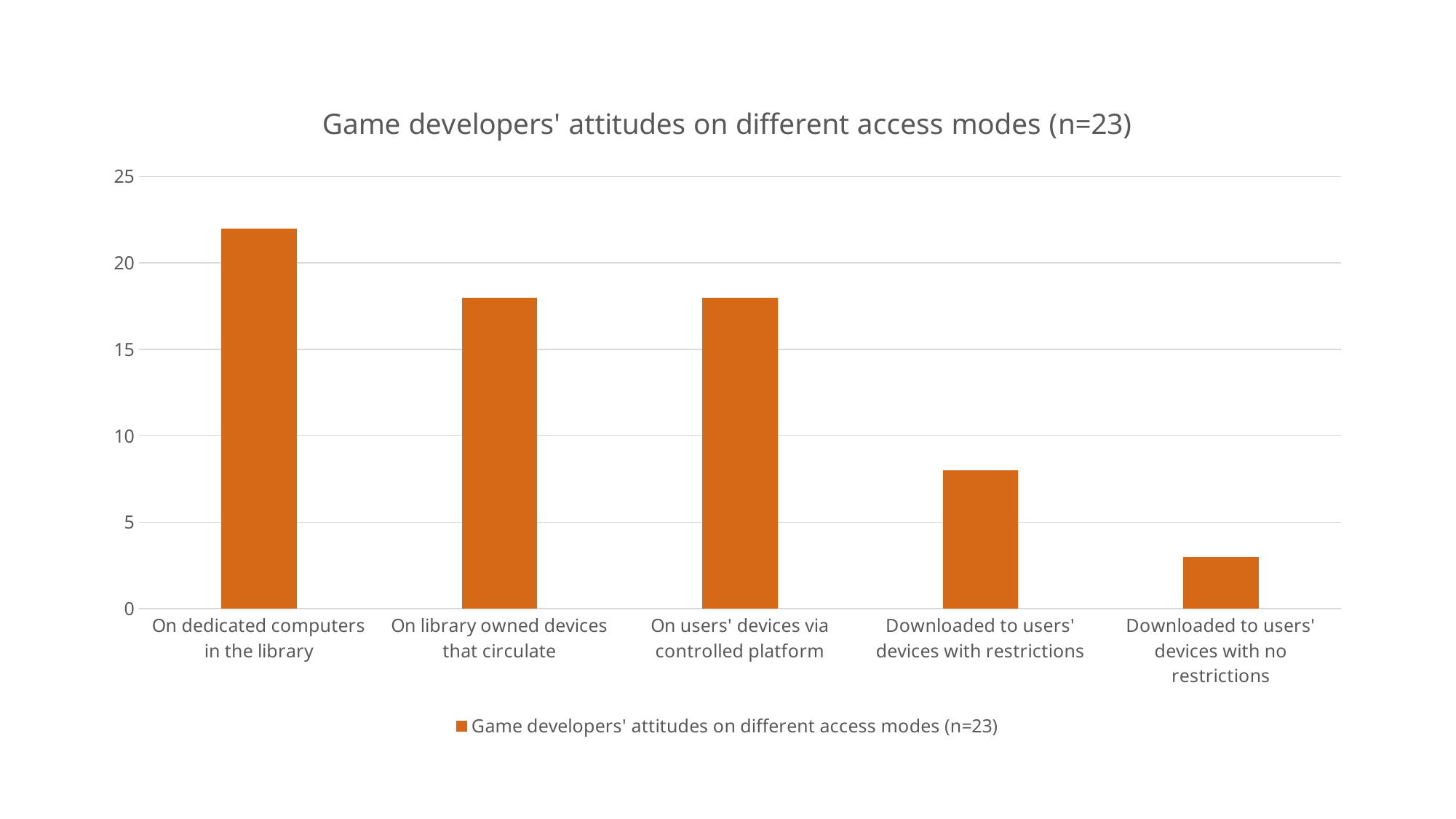
How many series does the legend list? 1 How many categories (access modes) are shown on the x axis? 5 Which access mode has the lowest value? Downloaded to users' devices with no restrictions Do the values generally rise or fall moving from left to right along the x axis? fall Which is larger: the value for 'On dedicated computers in the library' or for 'Downloaded to users' devices with restrictions'? On dedicated computers in the library Is the value for 'On library owned devices that circulate' greater or less than 20? less Is the value for 'Downloaded to users' devices with no restrictions' greater or less than 5? less What kind of chart is shown on the slide? Bar chart Which access mode has the highest value? On dedicated computers in the library Is the value for 'On dedicated computers in the library' greater or less than 20? greater What is the title of the chart? Game developers' attitudes on different access modes (n=23)